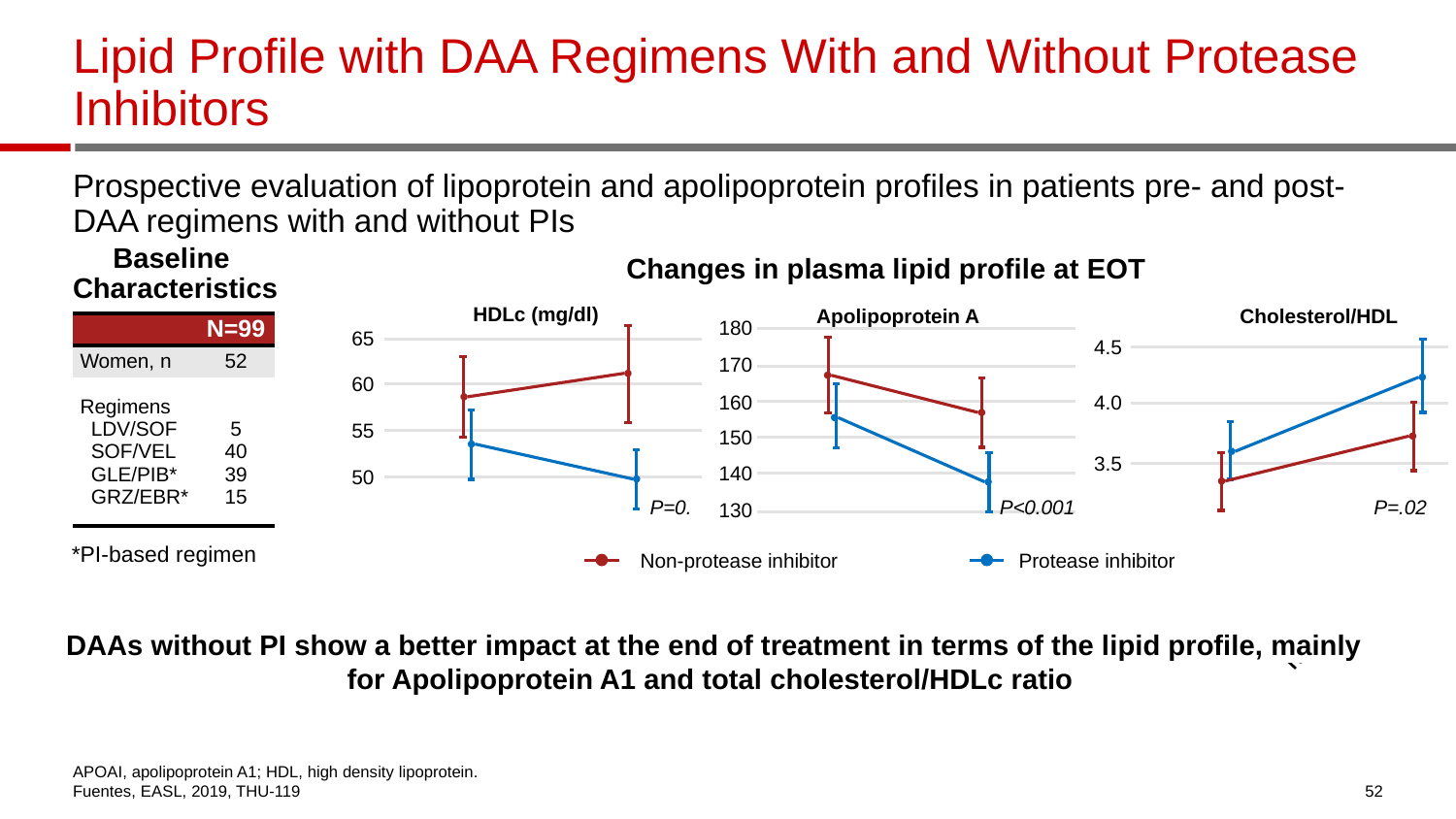
What kind of chart is the HDLc (mg/dl) chart? line chart In the Apolipoprotein A chart, is the first value for Non-protease inhibitor greater or less than 160? greater In the Cholesterol/HDL chart, does the Protease inhibitor line rise or fall from the first point to the second? rise In the HDLc (mg/dl) chart, does the Protease inhibitor line rise or fall from the first point to the second? fall In the HDLc (mg/dl) chart, does the Non-protease inhibitor line rise or fall from the first point to the second? rise What P value is shown on the Apolipoprotein A chart? P<0.001 In the Cholesterol/HDL chart, is the second value for Protease inhibitor greater or less than 4.0? greater In the Cholesterol/HDL chart, which series has the higher value at the second point? Protease inhibitor In the Apolipoprotein A chart, which series has the higher value at the first point? Non-protease inhibitor How many series does the legend list for the lipid profile charts? 2 In the HDLc (mg/dl) chart, is the first value for Non-protease inhibitor greater or less than 60? less